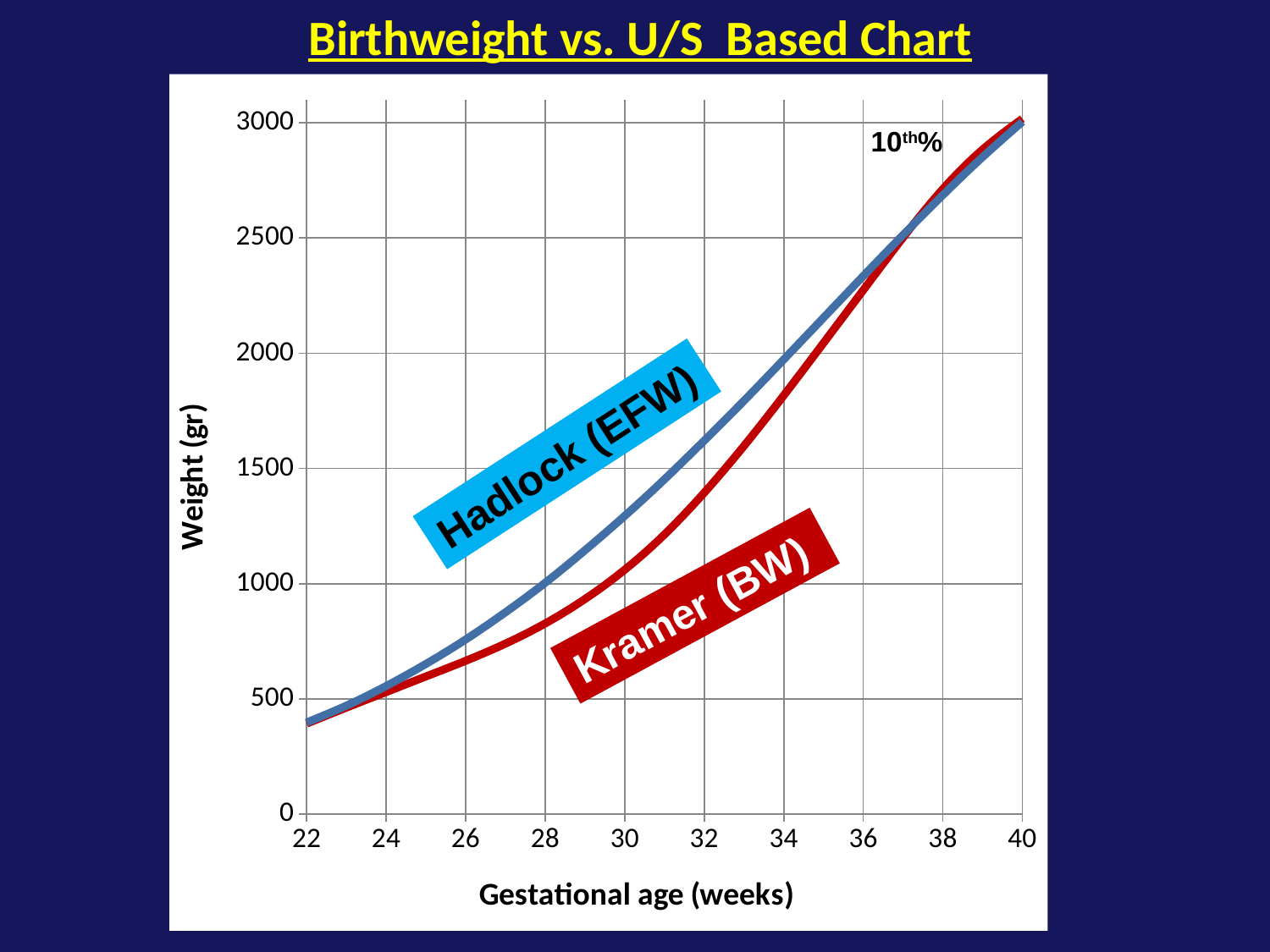
At 32 weeks, which series has the higher weight, Hadlock (EFW) or Kramer (BW)? Hadlock (EFW) Do the weight values rise or fall as gestational age increases? rise Is the Hadlock (EFW) value at 32 weeks greater or less than 1500? greater Is the Hadlock (EFW) value at 36 weeks greater or less than 2000? greater Is the Kramer (BW) value at 28 weeks greater or less than 1000? less What is the title of the chart on the slide? Birthweight vs. U/S Based Chart How many series are plotted on the chart? 2 At 30 weeks, which series has the lower weight, Hadlock (EFW) or Kramer (BW)? Kramer (BW) What colour is the Kramer (BW) line? red What kind of chart is shown on the slide? line chart